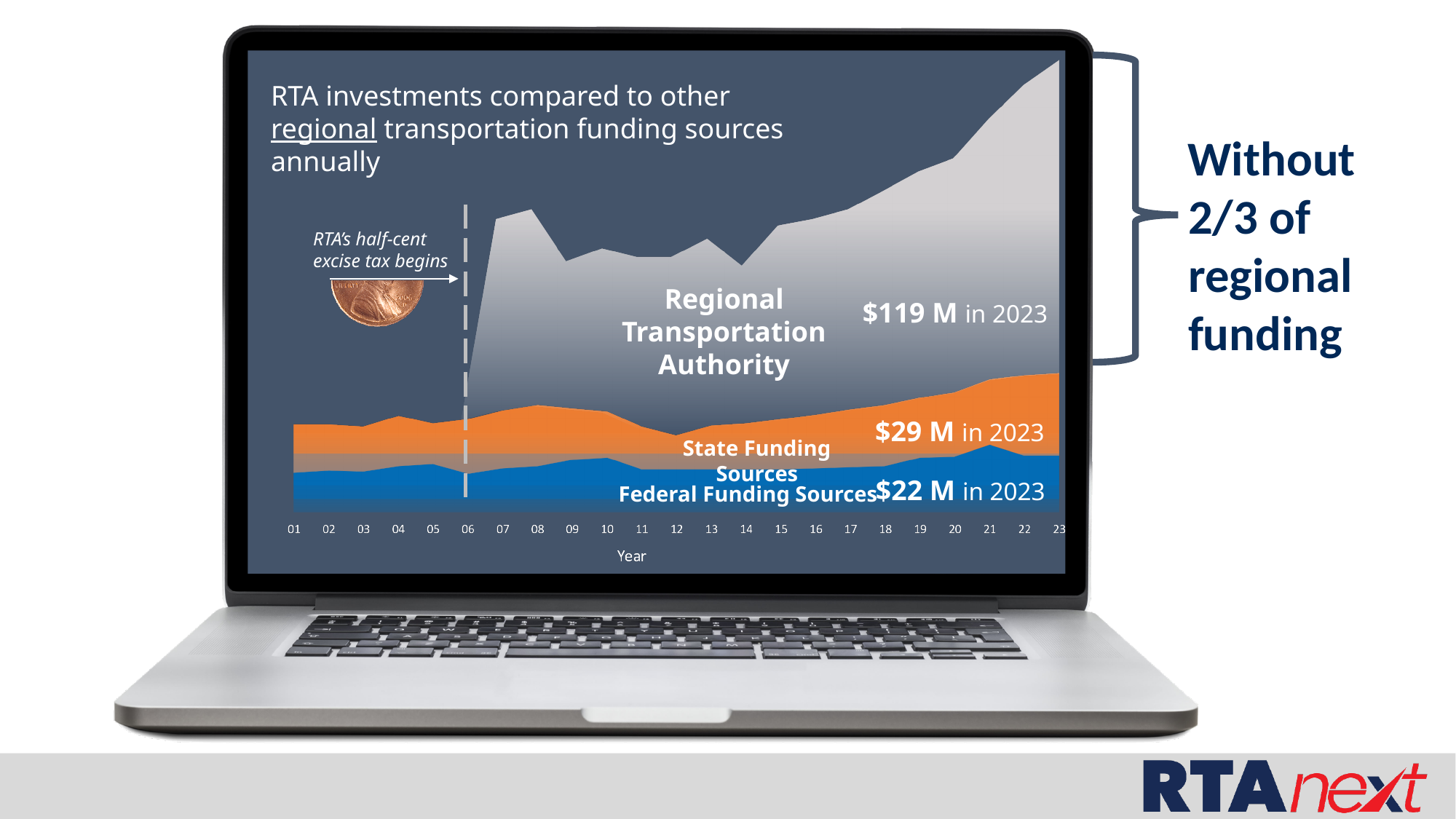
What type of chart is shown on the slide? Stacked area chart What was the value for State Funding Sources in 2023? $29 M How much larger was the Regional Transportation Authority value than the State Funding Sources value in 2023? $90 M How many funding series are shown in the chart? 3 What is the difference between State Funding Sources and Federal Funding Sources in 2023? $7 M How many years are shown on the x axis? 23 What is the total of the three funding sources in 2023? $170 M Which funding source had the lowest value in 2023? Federal Funding Sources What was the Regional Transportation Authority funding value in 2023? $119 M Which funding source had the highest value in 2023? Regional Transportation Authority In 2023, which was larger: State Funding Sources or Federal Funding Sources? State Funding Sources What was the value for Federal Funding Sources in 2023? $22 M